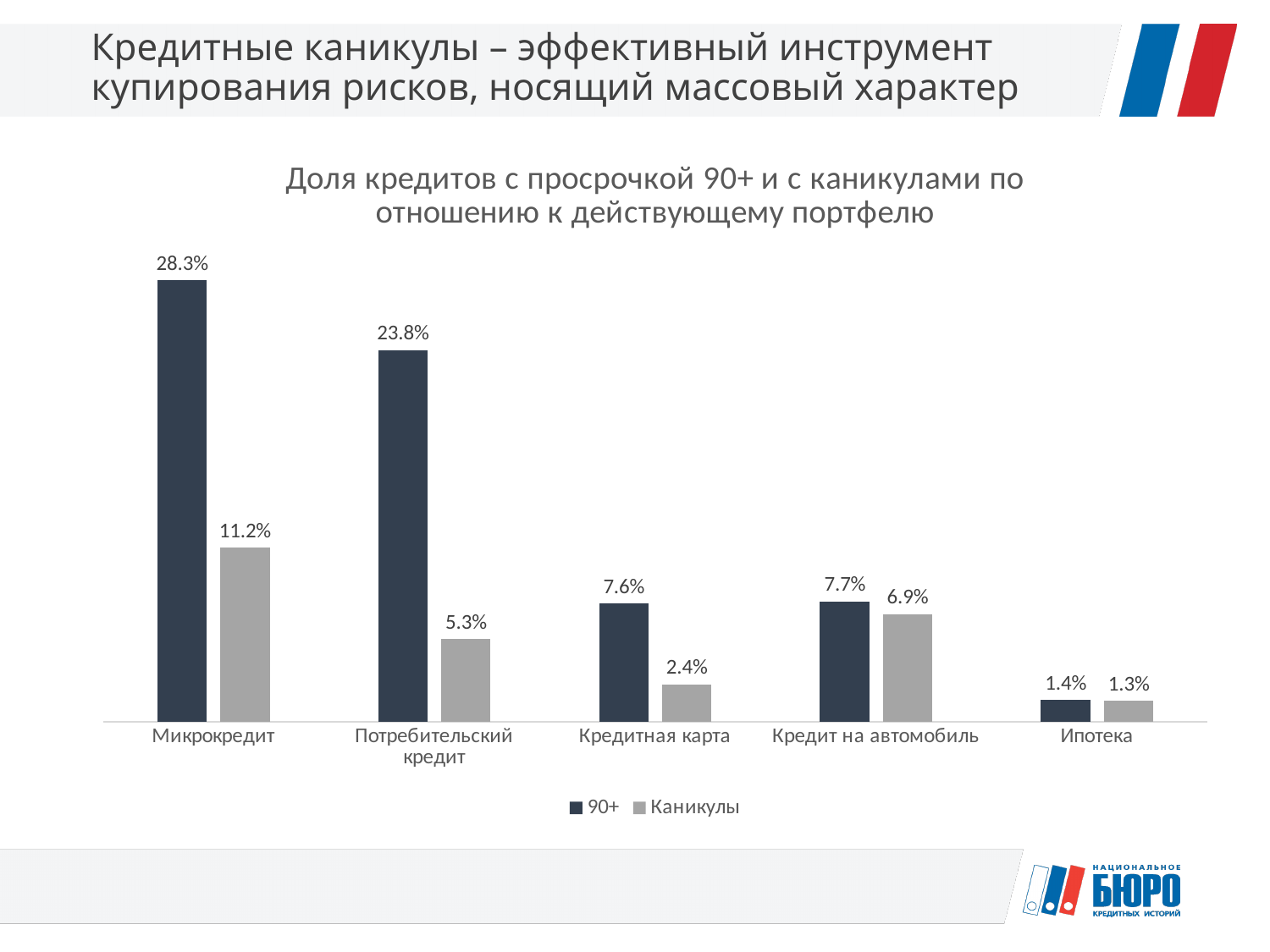
What is the Каникулы value for Кредит на автомобиль? 6.9% How many categories are shown on the x axis? 5 What is the difference between the 90+ and Каникулы values for Микрокредит? 17.1% What kind of chart is shown on the slide? Bar chart Which is larger: the Каникулы value for Микрокредит or the 90+ value for Кредитная карта? Каникулы value for Микрокредит Which category has the highest 90+ value? Микрокредит What is the difference between the 90+ values for Потребительский кредит and Кредитная карта? 16.2% What is the 90+ value for Микрокредит? 28.3% What is the Каникулы value for Потребительский кредит? 5.3% What are the two series named in the legend? 90+ and Каникулы How many series does the legend list? 2 Which category has the lowest Каникулы value? Ипотека